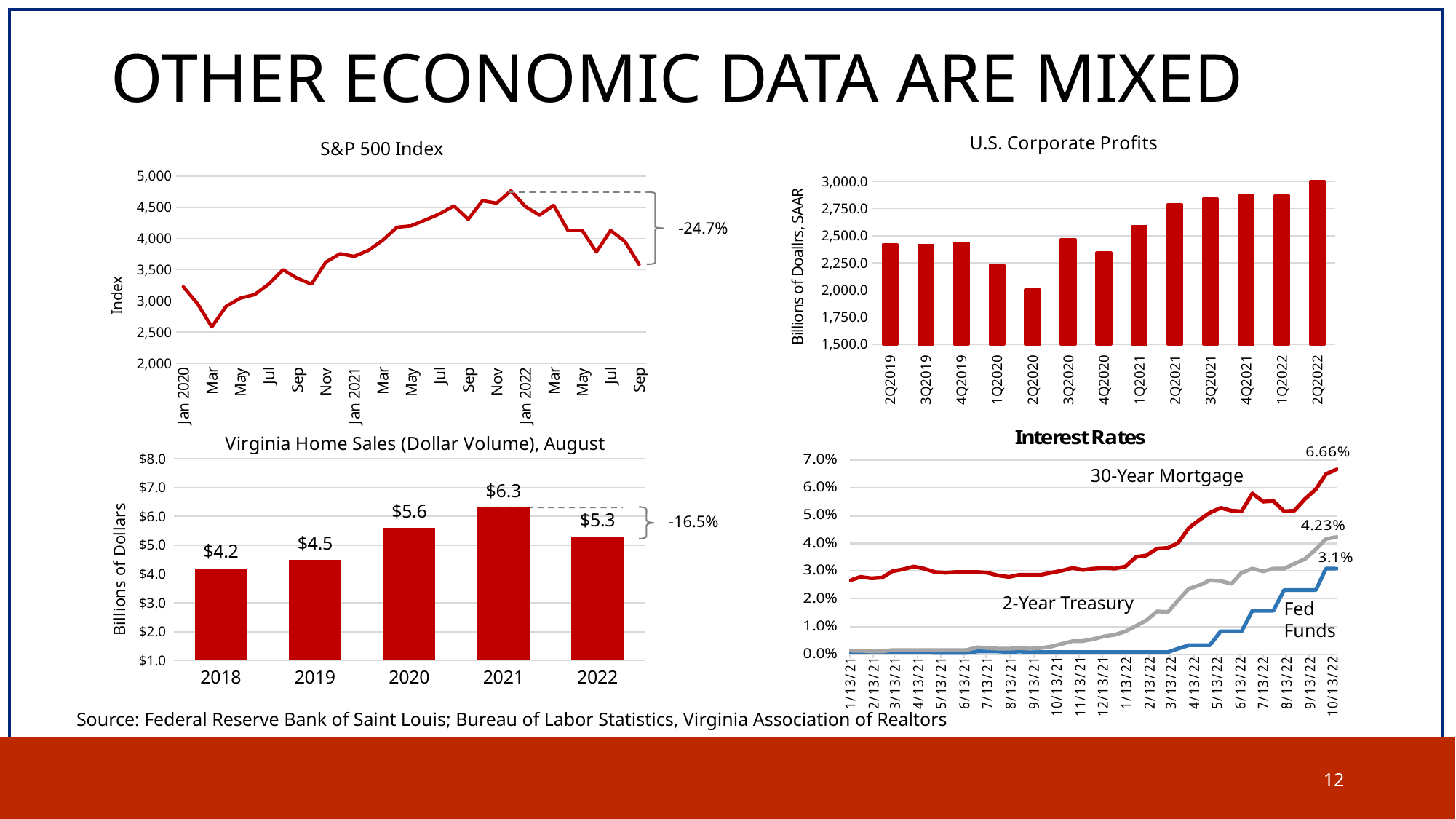
On the Virginia Home Sales (Dollar Volume), August chart, what is the difference between the 2021 and 2022 values? $1.0 On the U.S. Corporate Profits chart, which quarter has the lowest value? 2Q2020 On the U.S. Corporate Profits chart, which quarter has the highest value? 2Q2022 On the Virginia Home Sales (Dollar Volume), August chart, which year has the lowest value? 2018 On the Virginia Home Sales (Dollar Volume), August chart, how many years are shown? 5 On the Interest Rates chart, which is larger at the end of the series: the 2-Year Treasury or the Fed Funds rate? 2-Year Treasury On the Virginia Home Sales (Dollar Volume), August chart, what is the value for 2021? $6.3 On the U.S. Corporate Profits chart, how many quarters are shown? 13 On the Interest Rates chart, what is the final labelled value for the 30-Year Mortgage line? 6.66% What kind of chart is the S&P 500 Index chart? line chart On the U.S. Corporate Profits chart, is the value for 2Q2020 greater or less than 2,250.0? less On the S&P 500 Index chart, what percentage change is annotated for the decline from the peak to Sep 2022? -24.7%